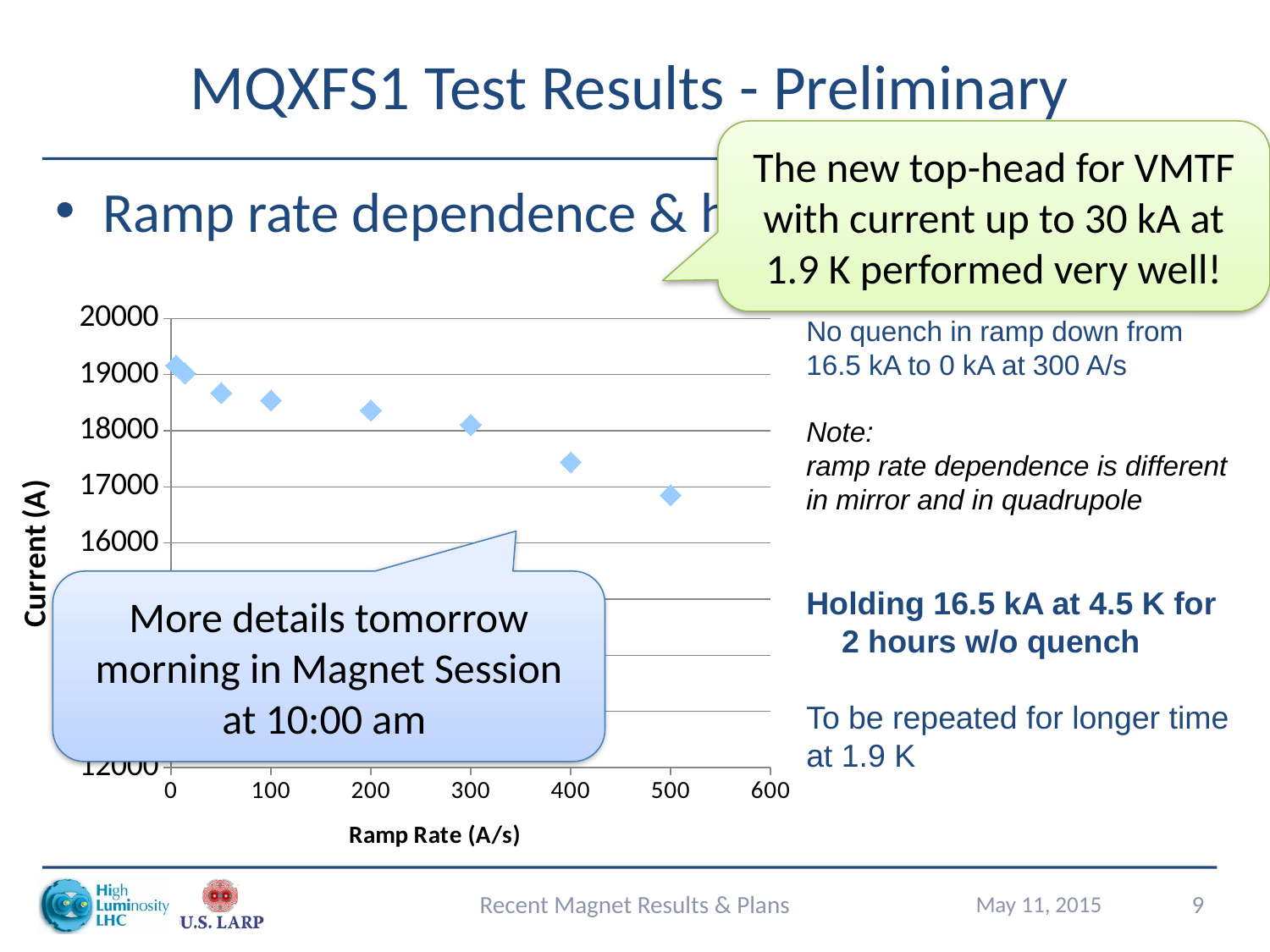
At which ramp rate is the plotted current lowest? 500 A/s Is the current at a ramp rate of 100 A/s greater or less than 18000? greater What kind of chart is shown on the slide? scatter chart Does the current rise or fall as the ramp rate increases along the x axis? fall What is the label of the y axis of the chart? Current (A) Is the current at a ramp rate of 300 A/s greater or less than 17000? greater Is the current at a ramp rate of 500 A/s greater or less than 18000? less What is the label of the x axis of the chart? Ramp Rate (A/s) Which has the higher current: the point at a ramp rate of 100 A/s or the point at 400 A/s? 100 A/s Which has the higher current: the point at a ramp rate of 50 A/s or the point at 500 A/s? 50 A/s